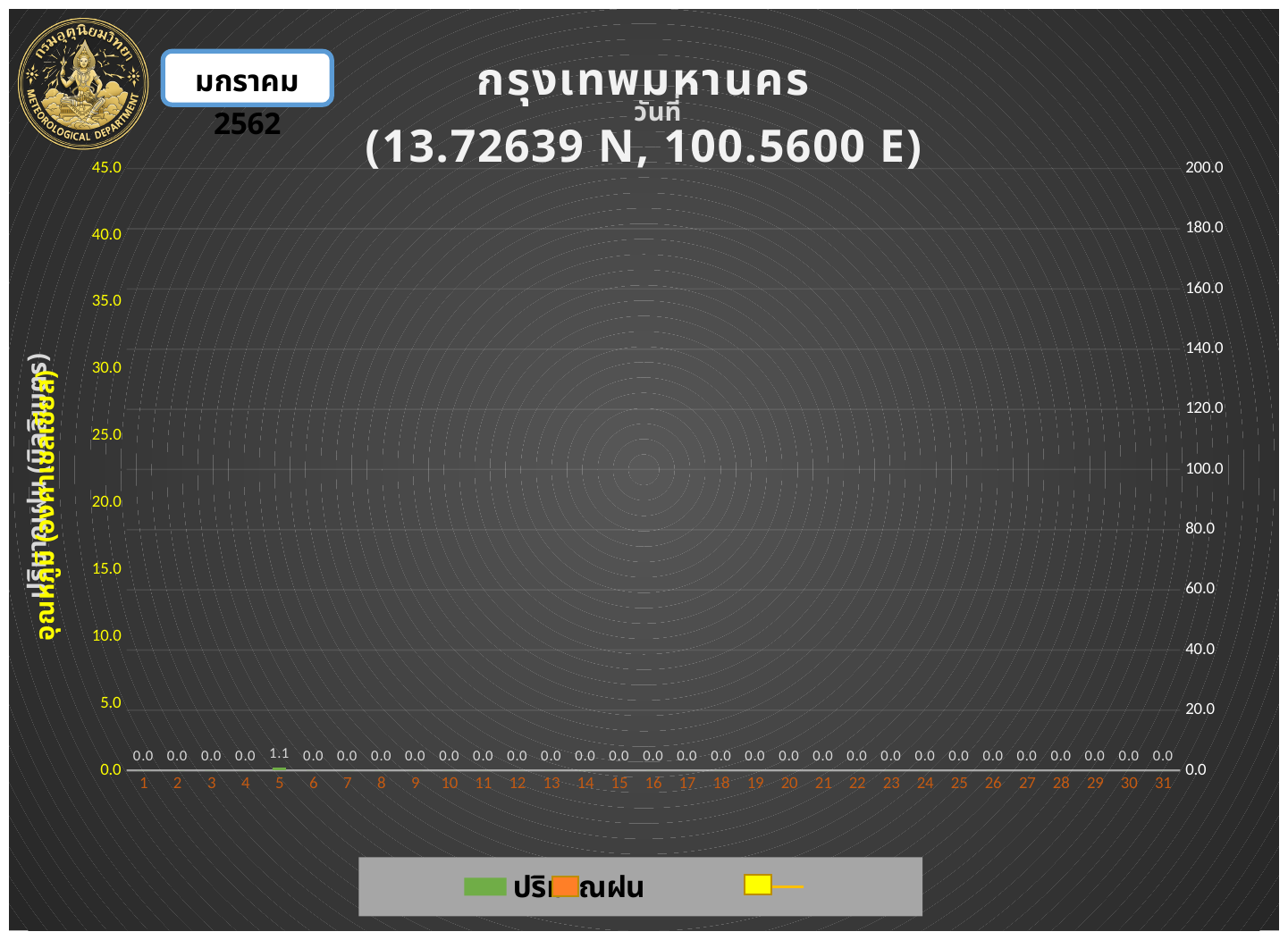
What is the difference between the value for day 5 and the value for day 6? 1.1 Which day has the highest value? 5 Which is larger, the value for day 5 or the value for day 10? day 5 What kind of chart is this? bar chart Is the value for day 5 greater or less than 5.0 on the left axis? less What is the maximum value shown on the right y axis? 200.0 What is the maximum value shown on the left y axis? 45.0 What is the data label for day 16? 0.0 How many days are shown on the x axis? 31 What is the data label for day 31? 0.0 What is the data label for day 5? 1.1 What is the data label for day 1? 0.0